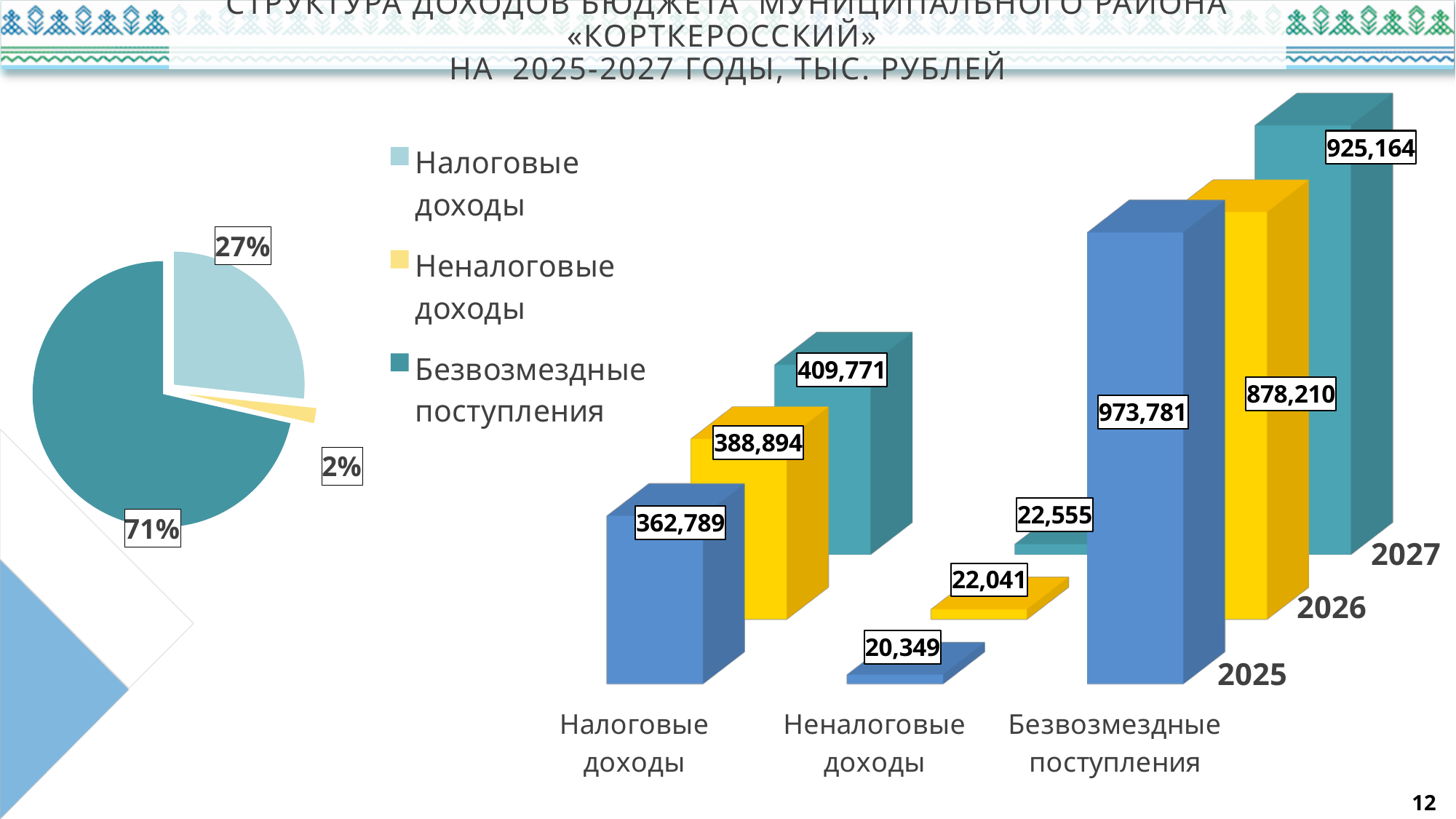
In the bar chart on the right, what is the difference between Налоговые доходы in 2027 and in 2025? 46,982 In the bar chart on the right, what is the value for Налоговые доходы in 2025? 362,789 In the bar chart on the right, which is larger: Безвозмездные поступления in 2025 or in 2027? 2025 In the bar chart on the right, which category has the highest value in 2027? Безвозмездные поступления In the bar chart on the right, what is the value for Безвозмездные поступления in 2026? 878,210 What kind of chart is the chart on the right side of the slide? Bar chart In the bar chart on the right, what is the value for Неналоговые доходы in 2027? 22,555 In the pie chart on the left, what share does Налоговые доходы have? 27% In the pie chart on the left, which category has the smallest slice? Неналоговые доходы In the pie chart on the left, what share does Безвозмездные поступления have? 71% How many entries does the legend of the pie chart on the left list? 3 In the bar chart on the right, do the values for Налоговые доходы rise or fall from 2025 to 2027? Rise